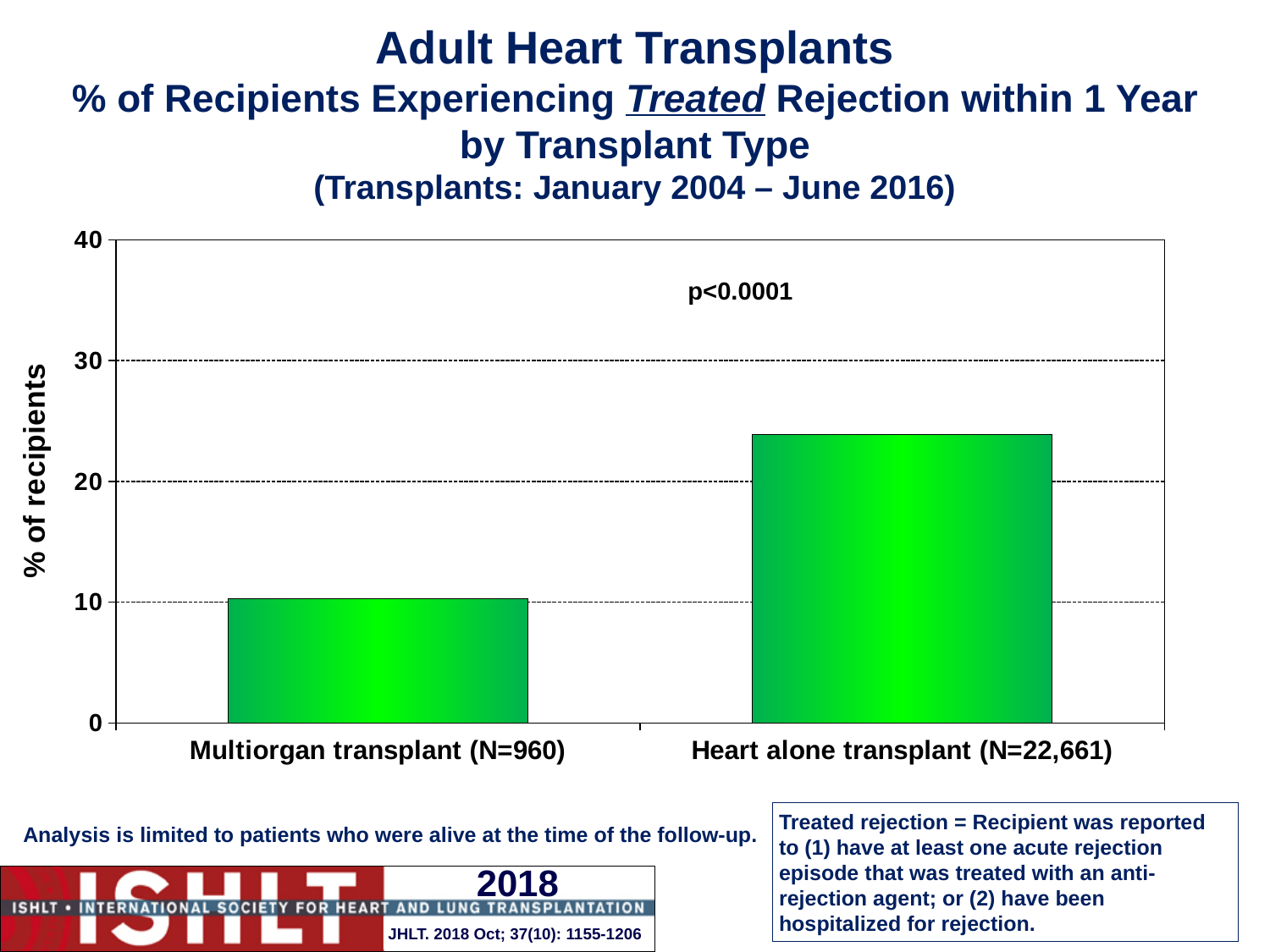
Which transplant type has the lower % of recipients experiencing treated rejection within 1 year? Multiorgan transplant (N=960) Is the value for Multiorgan transplant (N=960) greater or less than 20? less What kind of chart is shown on the slide? bar chart Is the value for Heart alone transplant larger or smaller than the value for Multiorgan transplant? larger Is the value for Heart alone transplant (N=22,661) greater or less than 20? greater Which transplant type has the higher % of recipients experiencing treated rejection within 1 year? Heart alone transplant (N=22,661) Do the bar values rise or fall moving from left to right along the x axis? rise What p-value is printed on the chart? p<0.0001 What is the label on the y axis of the chart? % of recipients How many categories (bars) are plotted in the chart? 2 Is the value for Heart alone transplant (N=22,661) greater or less than 30? less